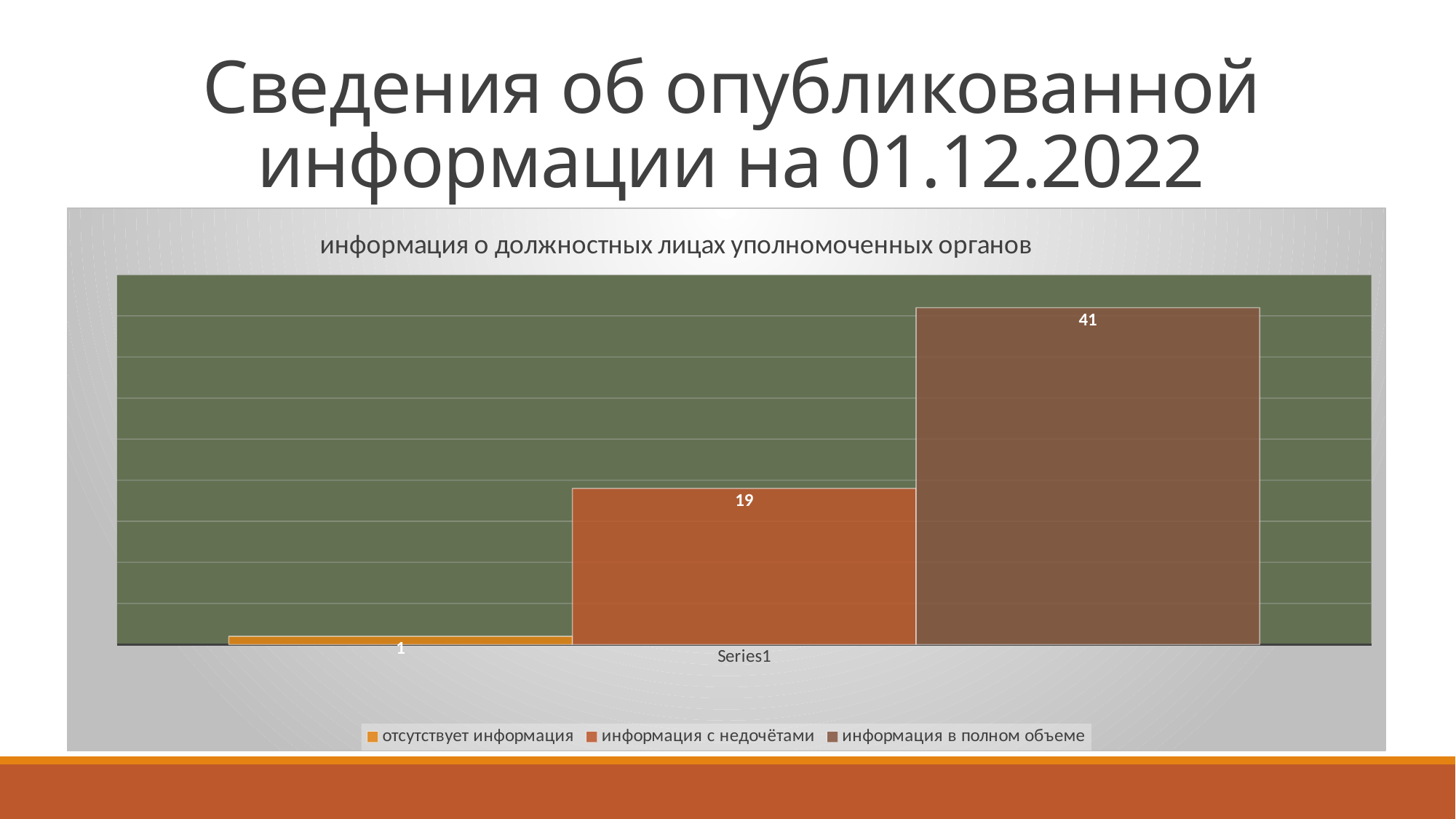
What is the value for "информация с недочётами"? 19 What is the category label shown on the x axis? Series1 What is the value for "отсутствует информация"? 1 What is the difference between the values for "информация с недочётами" and "отсутствует информация"? 18 Which series has the highest value? информация в полном объеме Which is larger: the value for "информация с недочётами" or the value for "отсутствует информация"? информация с недочётами What is the difference between the values for "информация в полном объеме" and "информация с недочётами"? 22 How many series does the legend list? 3 What is the title of the chart? информация о должностных лицах уполномоченных органов Which series has the lowest value? отсутствует информация What kind of chart is shown on the slide? bar chart What is the value for "информация в полном объеме"? 41